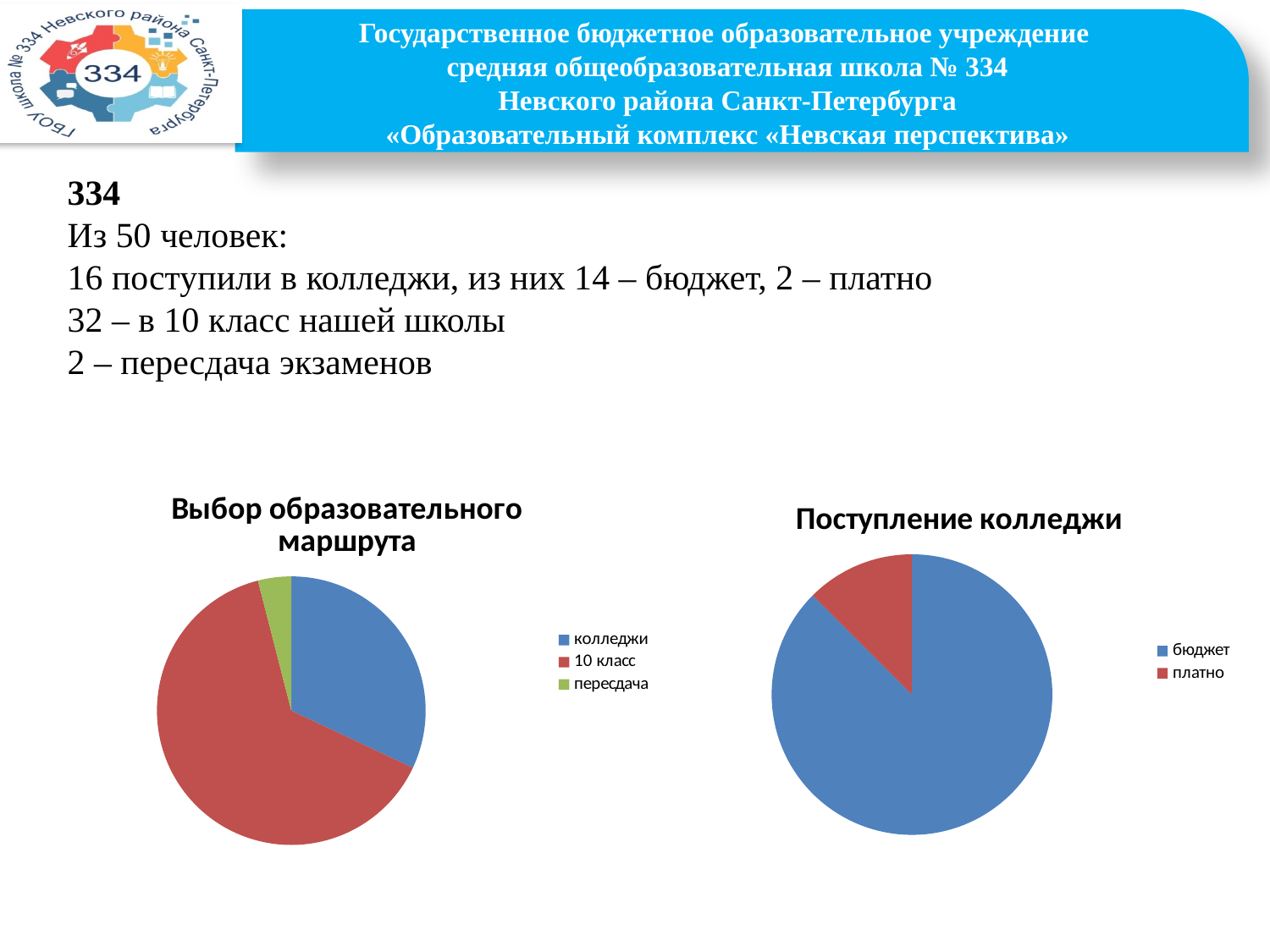
In the chart "Поступление колледжи", which slice is larger: бюджет or платно? бюджет In the chart "Выбор образовательного маршрута", how many categories does the legend list? 3 What is the title of the pie chart on the left of the slide? Выбор образовательного маршрута In the chart "Выбор образовательного маршрута", which category has the smallest slice? пересдача In the chart "Выбор образовательного маршрута", what colour is the slice for 10 класс? red In the chart "Выбор образовательного маршрута", which category has the largest slice? 10 класс What kind of chart is the chart titled "Выбор образовательного маршрута"? pie chart In the chart "Поступление колледжи", how many categories does the legend list? 2 In the chart "Поступление колледжи", which category has the smallest slice? платно In the chart "Поступление колледжи", which category has the largest slice? бюджет What kind of chart is the chart titled "Поступление колледжи"? pie chart In the chart "Выбор образовательного маршрута", which slice is larger: колледжи or пересдача? колледжи